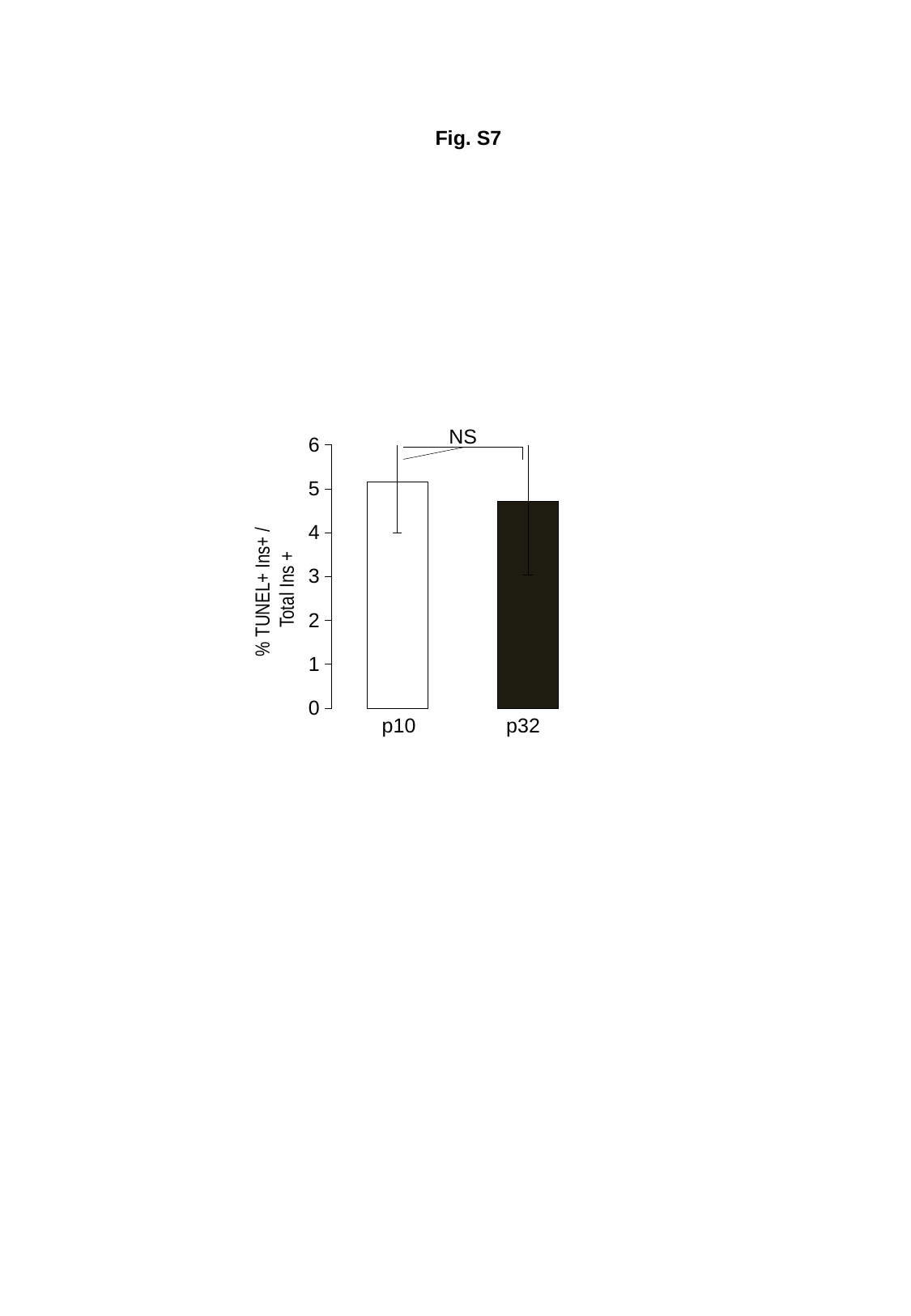
What kind of chart is shown on the slide? bar chart Is the value for p10 greater or less than 4? greater What is the label on the y axis of the chart? % TUNEL+ Ins+ / Total Ins + Which category has the higher bar, p10 or p32? p10 Is the value for p10 greater or less than 6? less Which category has the highest value in the chart? p10 Is the value for p32 greater or less than 5? less How many bars (categories) are plotted in the chart? 2 What annotation is written above the bracket connecting the two bars? NS Which category has the lowest value in the chart? p32